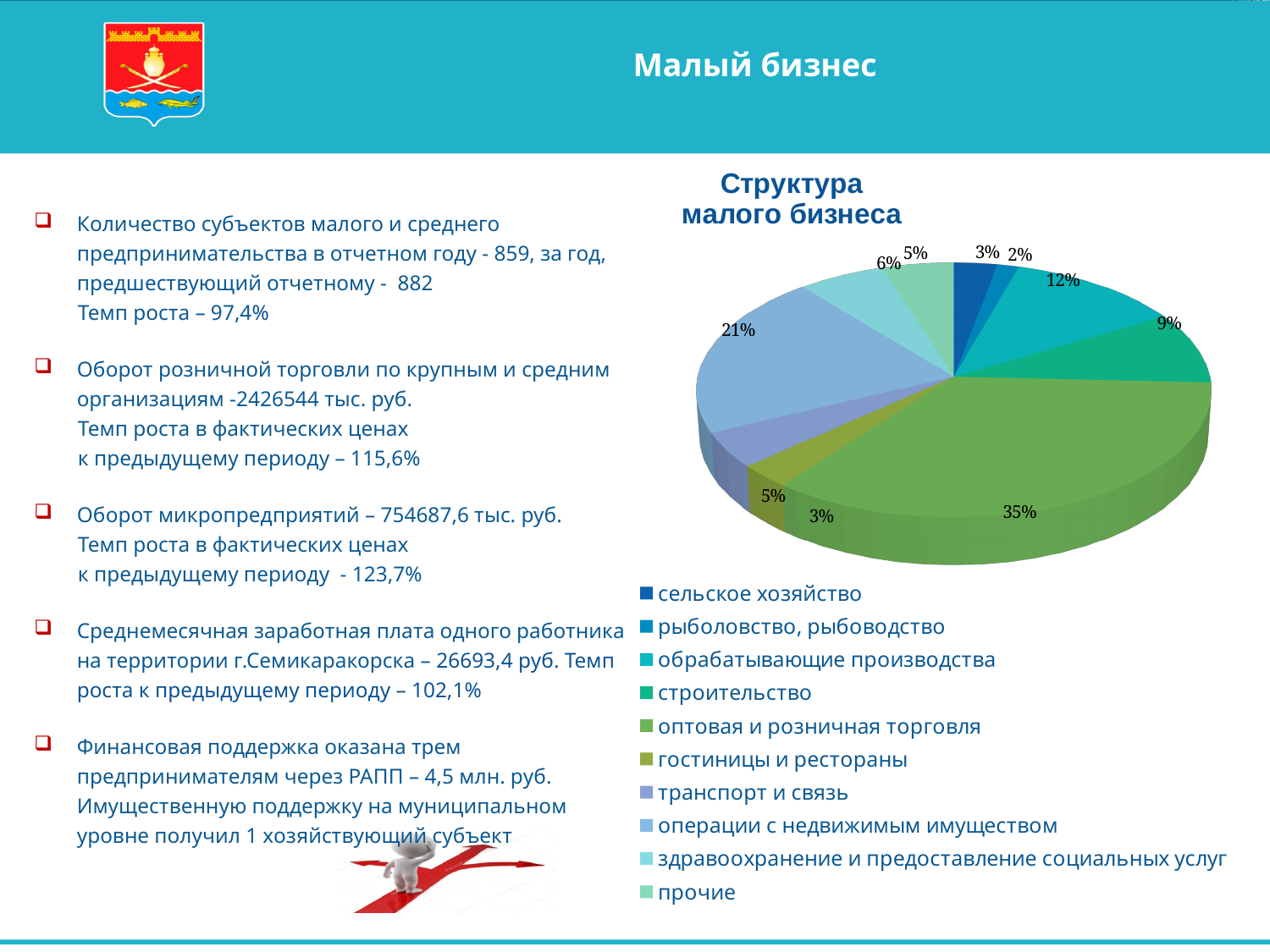
What share of the pie is операции с недвижимым имуществом? 21% What is the title of the chart? Структура малого бизнеса What is the difference in percentage points between оптовая и розничная торговля and операции с недвижимым имуществом? 14 What share of the pie is оптовая и розничная торговля? 35% Which is larger: the share for обрабатывающие производства or the share for строительство? обрабатывающие производства What type of chart is shown on the slide? pie chart Which category has the largest share of the pie? оптовая и розничная торговля What is the share of the pie for здравоохранение и предоставление социальных услуг? 6% How many categories does the chart's legend list? 10 Which category has the smallest share of the pie? рыболовство, рыбоводство